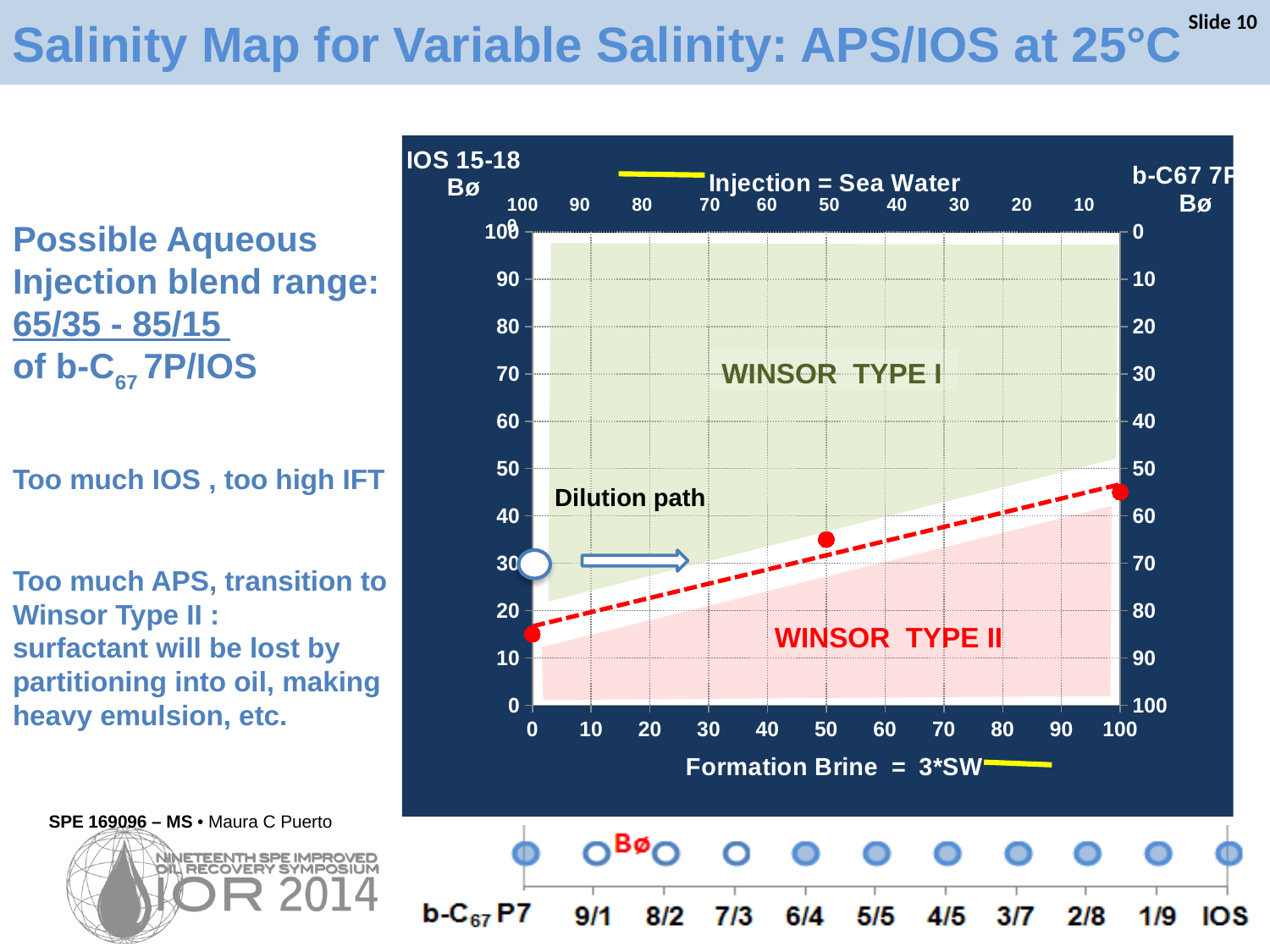
Is the value of the red dashed line at Formation Brine 100 greater or less than 40? greater Which red point on the dashed line is higher: the one at Formation Brine 0 or the one at Formation Brine 100? Formation Brine 100 Which region label appears in the upper green area of the chart? WINSOR TYPE I What is the label of the bottom x axis? Formation Brine = 3*SW Is the value of the red point at Formation Brine 50 greater or less than 30? greater Does the red dashed line rise or fall as Formation Brine increases along the x axis? rise What kind of chart is shown on the slide? line chart How many red points are plotted on the dashed line? 3 Is the value of the red dashed line at Formation Brine 0 greater or less than 20? less How many tick labels are shown on the bottom x axis? 11